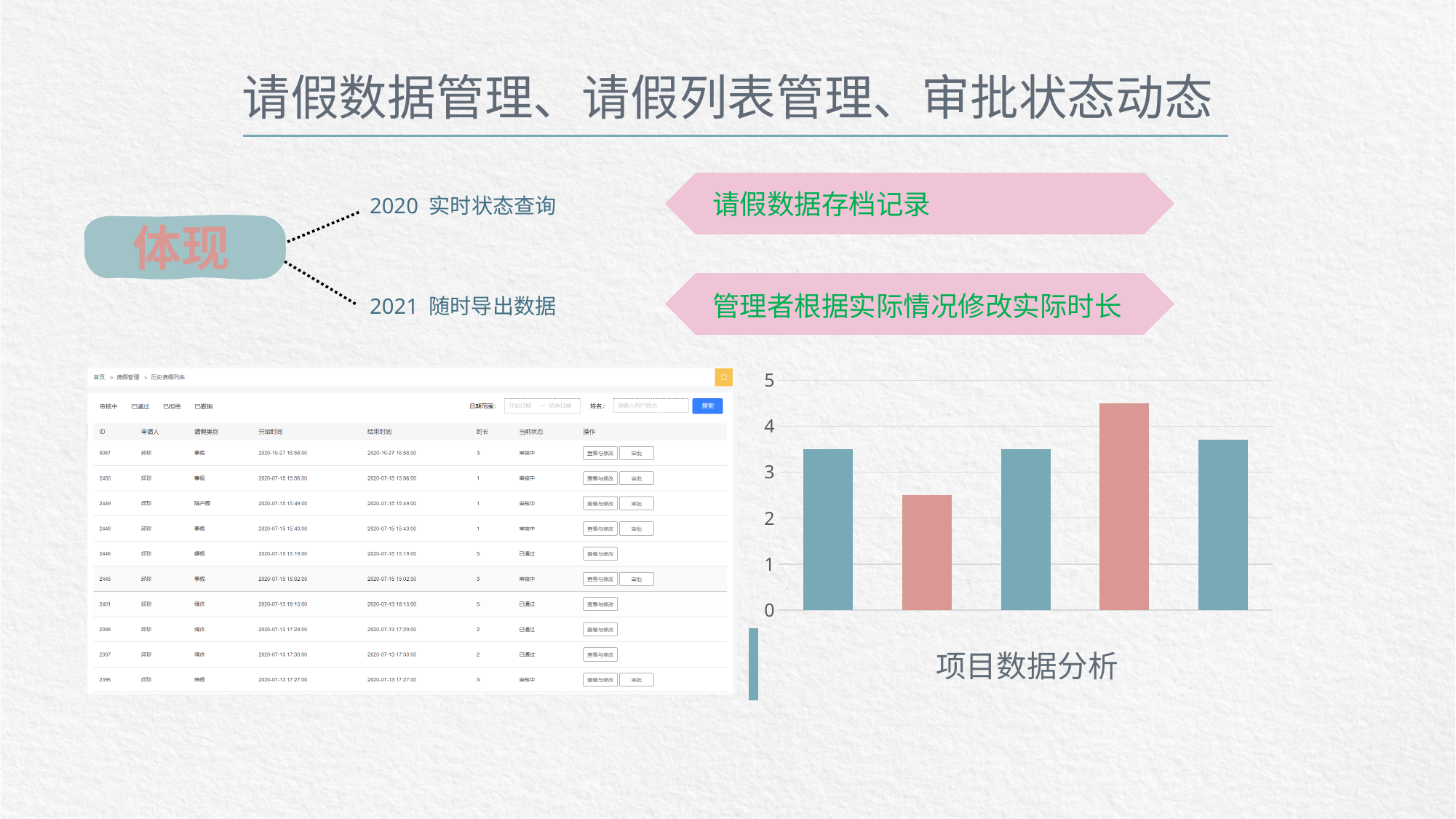
In the 项目数据分析 chart, is the value of the first bar from the left greater or less than 3? greater In the 项目数据分析 chart, which is taller: the second bar or the first bar? the first bar What kind of chart is shown under the title 项目数据分析? bar chart In the 项目数据分析 chart, which bar (by position from left) is the shortest? the second bar In the 项目数据分析 chart, is the value of the second bar from the left greater or less than 3? less In the 项目数据分析 chart, is the value of the fifth bar from the left greater or less than 4? less How many bars does the 项目数据分析 chart contain? 5 In the 项目数据分析 chart, which is taller: the second bar or the fourth bar? the fourth bar In the 项目数据分析 chart, which bar (by position from left) is the tallest? the fourth bar What is the highest value shown on the vertical axis of the 项目数据分析 chart? 5 What colour are the second and fourth bars in the 项目数据分析 chart? pink